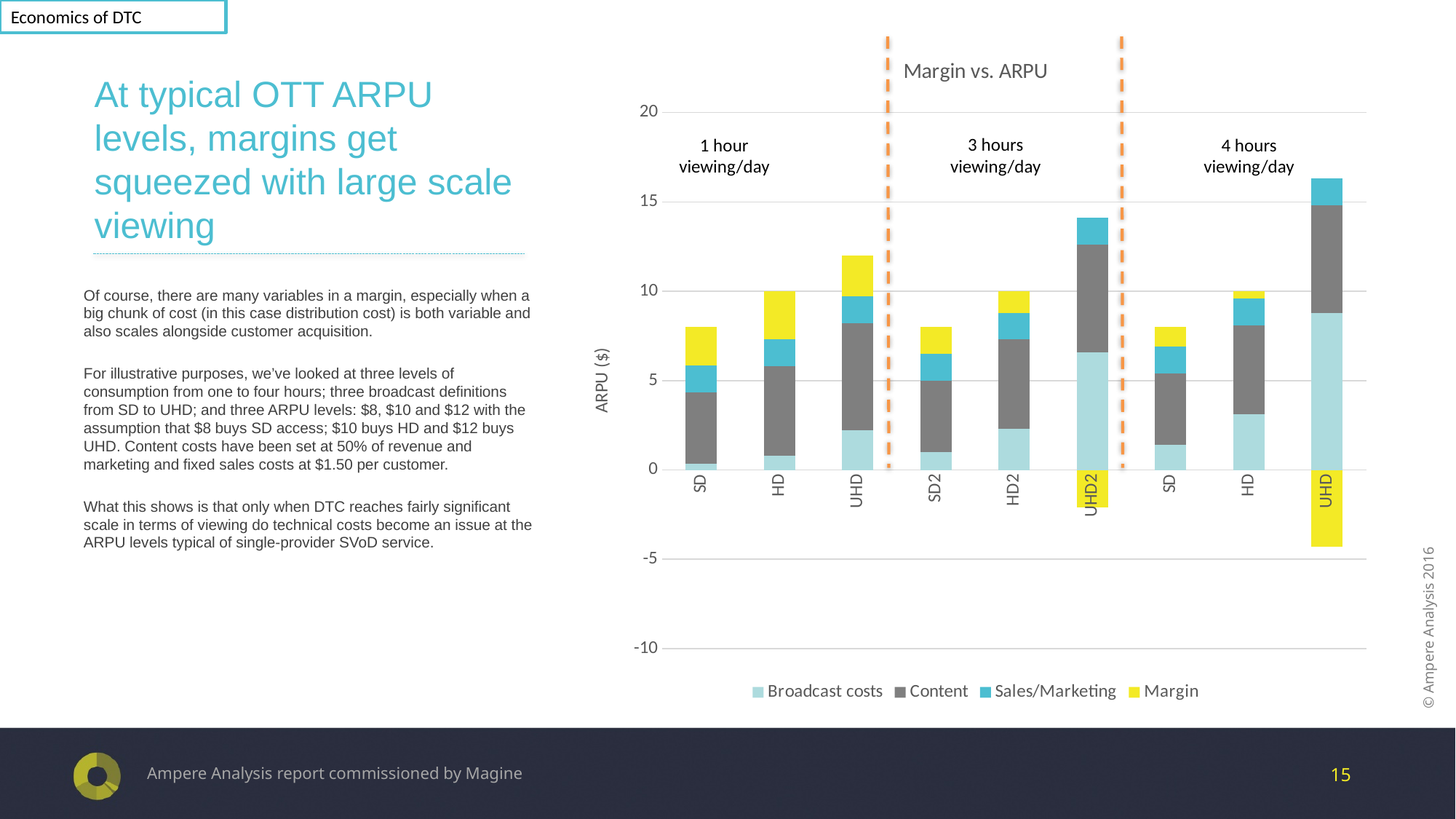
What is the label on the vertical axis of the chart? ARPU ($) Is the Margin segment for UHD2 in the 3 hours viewing/day group greater or less than 0? less How many bars are plotted in the chart? 9 Is the top of the SD bar in the 1 hour viewing/day group greater or less than 10? less Which bar reaches the highest total on the chart? UHD in the 4 hours viewing/day group Is the top of the UHD bar in the 4 hours viewing/day group greater or less than 15? greater How many series does the chart legend list? 4 What kind of chart is shown on the slide? Stacked bar chart Which has a larger Broadcast costs segment: SD in the 1 hour viewing/day group or UHD in the 4 hours viewing/day group? UHD in the 4 hours viewing/day group What is the title of the chart? Margin vs. ARPU